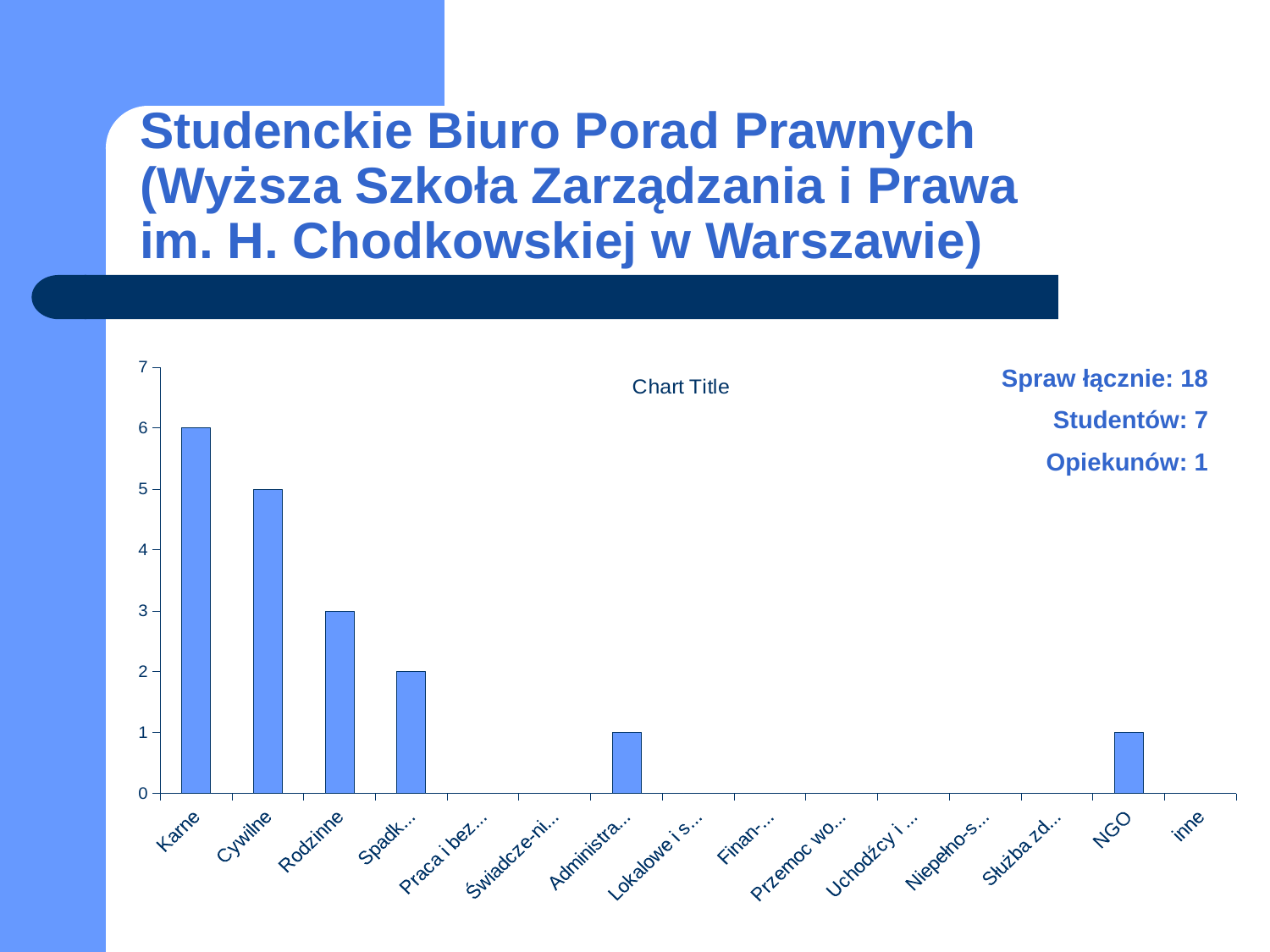
Which category has the highest value? Karne What is the difference between the values for Cywilne and Rodzinne? 2 What is the value for Cywilne? 5 What is the value for Rodzinne? 3 What is the title shown on the chart? Chart Title What type of chart is shown on the slide? bar chart What is the value for NGO? 1 How many categories are shown on the x axis? 15 Is the value for Karne greater or less than 4? greater What is the value for Karne? 6 Which is larger, the value for Rodzinne or the value for NGO? Rodzinne What is the difference between the values for Karne and Cywilne? 1